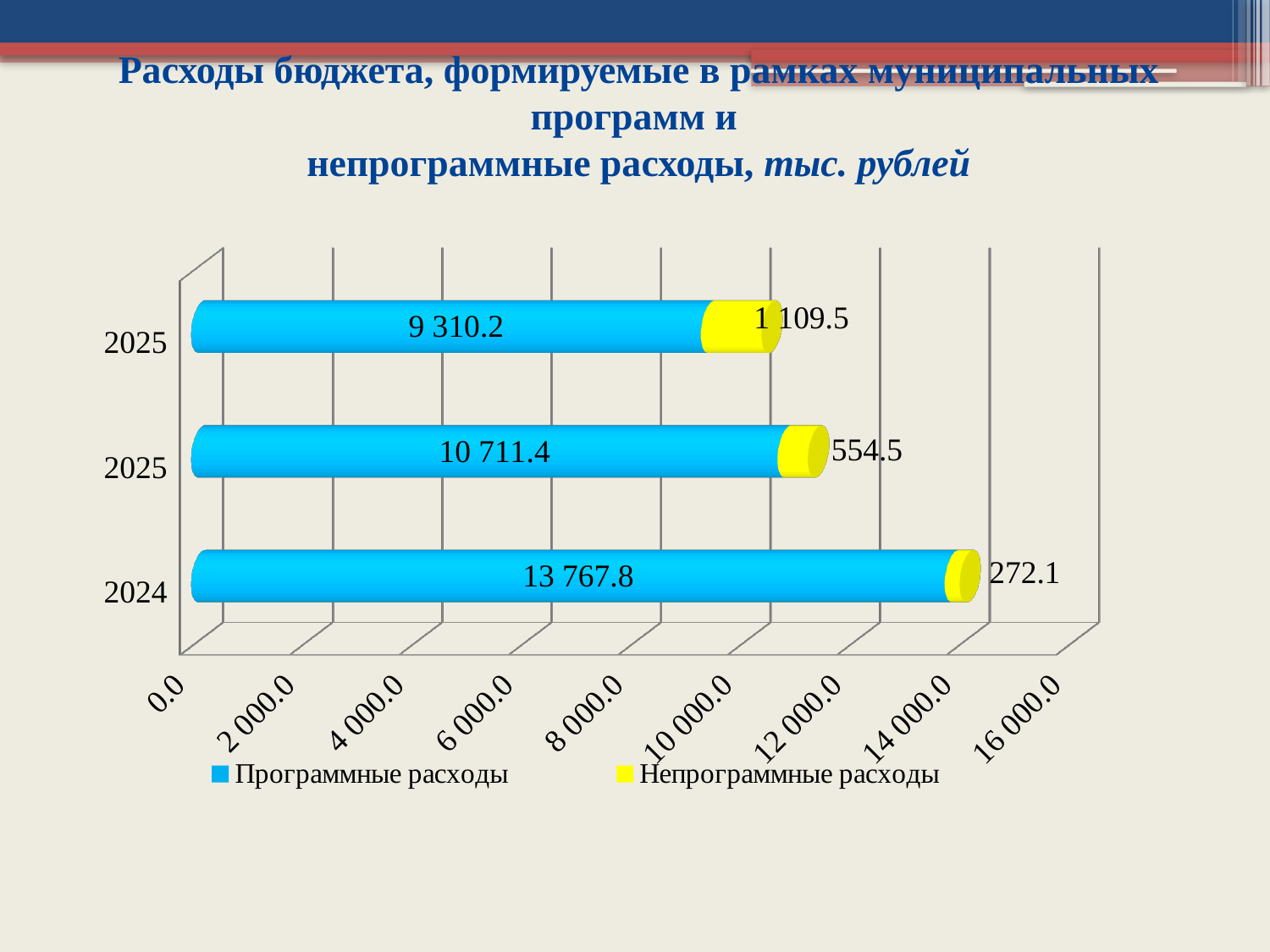
What is the difference between the Программные расходы value for 2024 and the Программные расходы value for the middle bar? 3 056.4 How many bars are shown in the chart? 3 Which bar has the highest value of Программные расходы? 2024 What is the value of Программные расходы for the top bar of the chart? 9 310.2 Which is larger: the Непрограммные расходы value for the top bar or for the middle bar? the top bar What is the total of the stacked bar for 2024? 14 039.9 Which bar has the lowest value of Непрограммные расходы? 2024 How many series does the legend list? 2 Is the Программные расходы value for 2024 greater or less than 12 000.0? greater What is the value of Непрограммные расходы for the middle bar of the chart? 554.5 What is the value of Непрограммные расходы for 2024? 272.1 What is the value of Программные расходы for 2024? 13 767.8